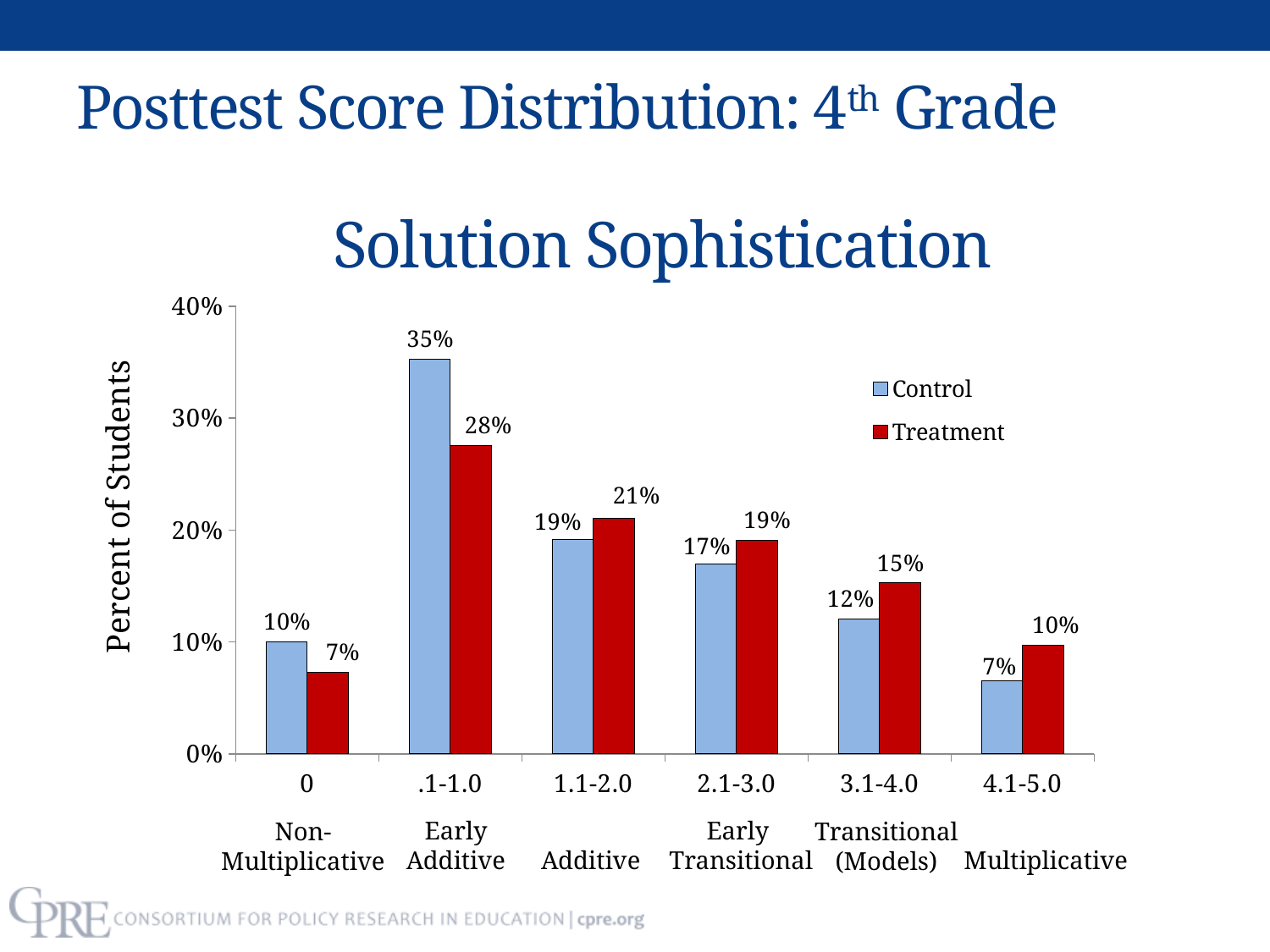
Which is larger for the 2.1-3.0 (Early Transitional) category, Control or Treatment? Treatment Is the Control value for the 1.1-2.0 (Additive) category greater or less than 20%? less How many series does the legend list? 2 What kind of chart is shown on the slide? Bar chart What is the Control value for the .1-1.0 (Early Additive) category? 35% What is the Treatment value for the 0 (Non-Multiplicative) category? 7% How many categories are shown on the x axis? 6 What is the label of the y axis? Percent of Students What is the Treatment value for the 3.1-4.0 (Transitional (Models)) category? 15% What is the difference between the Control and Treatment values for the .1-1.0 category? 7% Which category has the highest Treatment value? .1-1.0 (Early Additive) Which category has the lowest Control value? 4.1-5.0 (Multiplicative)